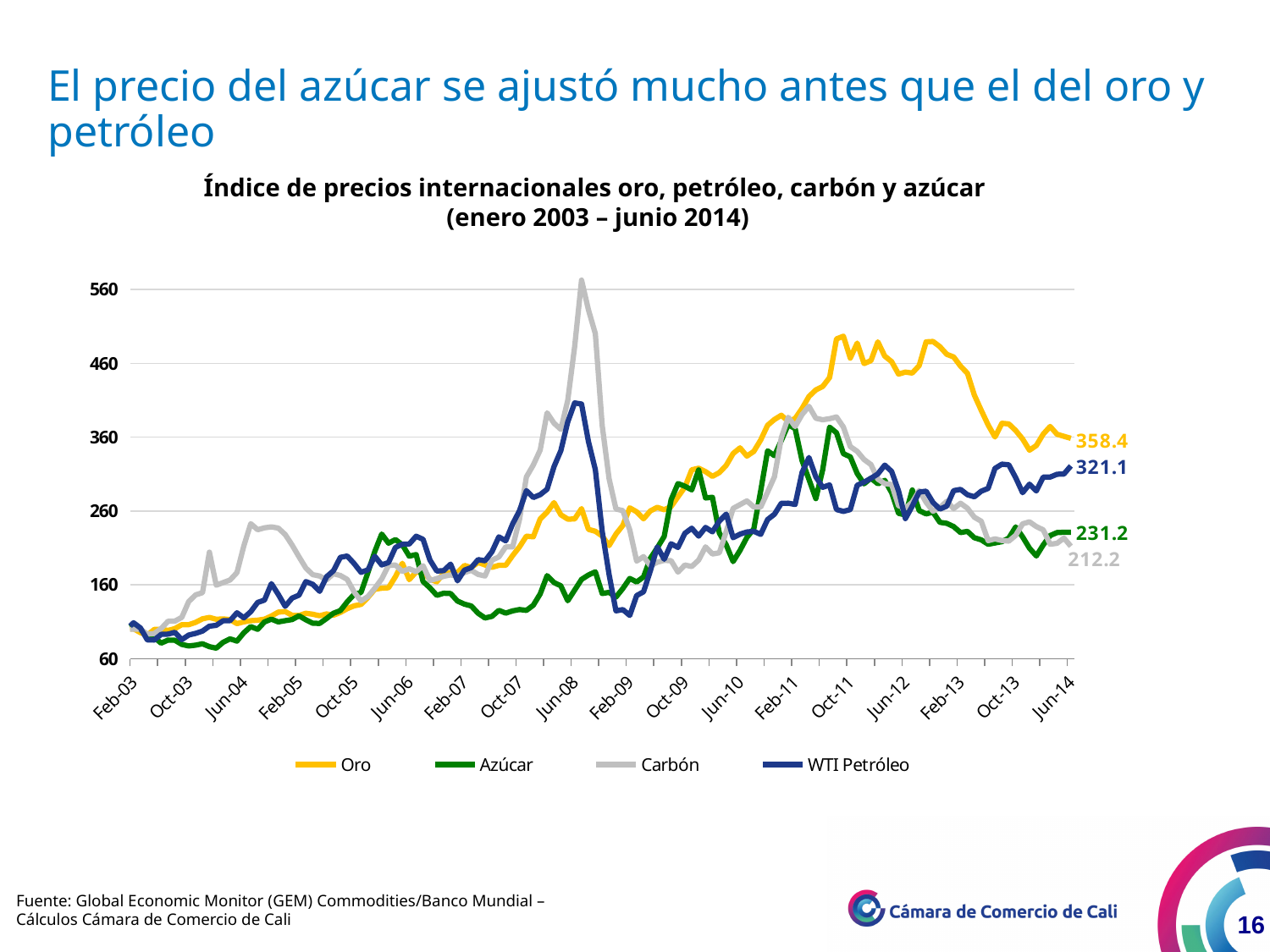
Which series has the lowest value at the end of the chart (Jun-14)? Carbón What is the final value shown for the Oro series at the right end of the chart? 358.4 What kind of chart is shown on the slide? Line chart What is the final value shown for the Carbón series? 212.2 What is the difference between the final values of Oro and WTI Petróleo? 37.3 At the end of the chart, which is larger: the Azúcar value or the Carbón value? Azúcar Does the Oro series generally rise or fall between Feb-03 and Oct-11? Rise What is the final value shown for the Azúcar series? 231.2 Is the peak value of the Carbón series around Jun-08 greater or less than 460? greater How many series does the legend list? 4 What is the final value shown for the WTI Petróleo series? 321.1 Which series has the highest value at the end of the chart (Jun-14)? Oro